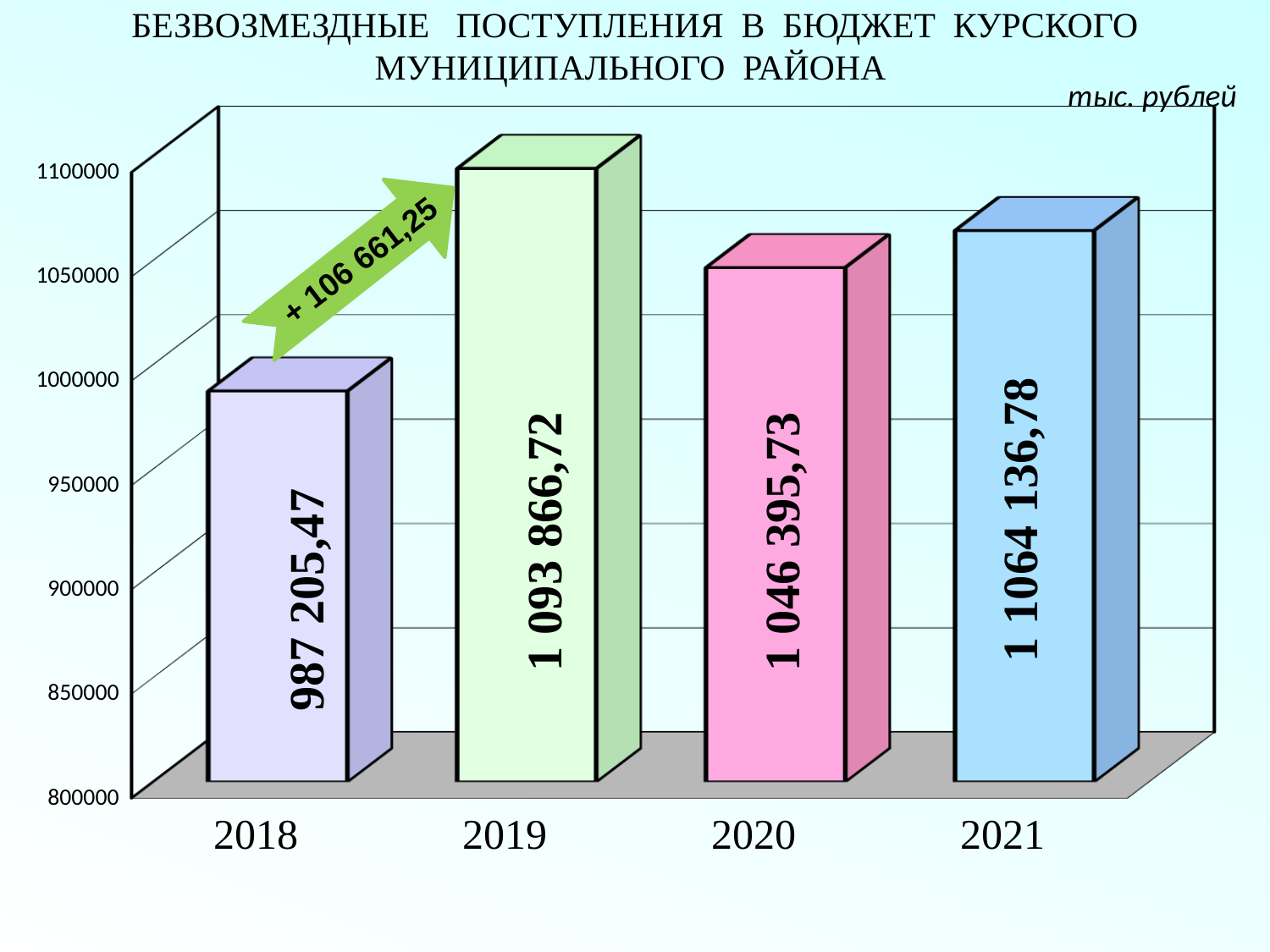
What kind of chart is shown on the slide? bar chart Which year has the lowest value? 2018 What is the value for 2019? 1 093 866,72 How many years are shown on the chart? 4 What is the value for 2020? 1 046 395,73 Which is larger, the value for 2020 or the value for 2021? 2021 Is the value for 2021 greater or less than 1050000? greater What is the increase from 2018 to 2019 shown on the arrow? + 106 661,25 What is the difference between the values for 2019 and 2020? 47 470,99 In what units are the values on the chart given? тыс. рублей Which year has the highest value? 2019 What is the value for 2018? 987 205,47